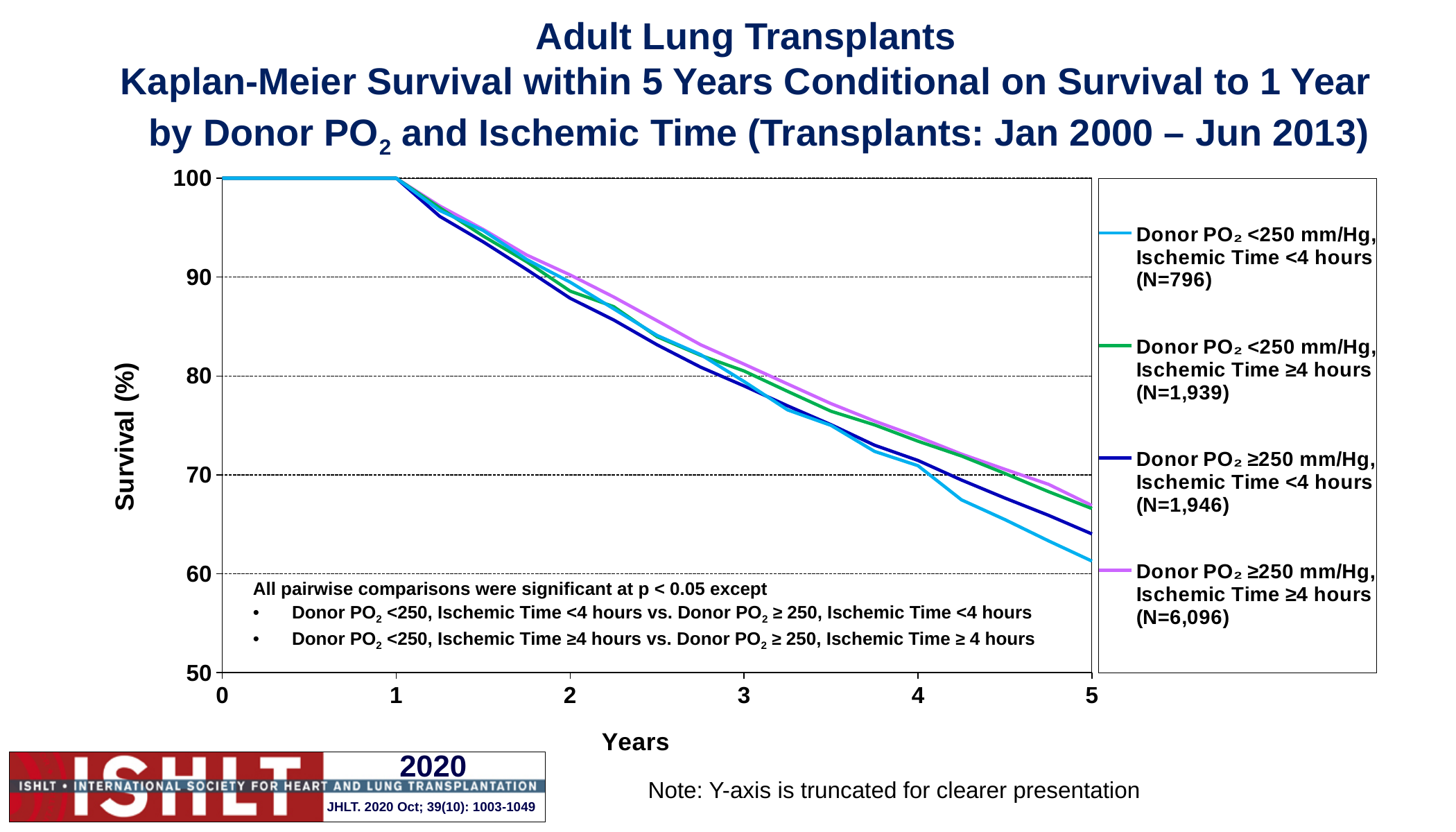
Is the survival value for the Donor PO₂ <250 mm/Hg, Ischemic Time <4 hours series at year 5 greater or less than 70? less At year 5, which series has the larger survival value: Donor PO₂ <250 mm/Hg, Ischemic Time <4 hours or Donor PO₂ ≥250 mm/Hg, Ischemic Time ≥4 hours? Donor PO₂ ≥250 mm/Hg, Ischemic Time ≥4 hours What is the label of the y axis? Survival (%) Is the survival value for the Donor PO₂ ≥250 mm/Hg, Ischemic Time ≥4 hours series at year 4 greater or less than 70? greater What kind of chart is shown on the slide? line chart How many series does the legend list? 4 What is the survival value for the Donor PO₂ ≥250 mm/Hg, Ischemic Time ≥4 hours series at year 1? 100 Is the survival value for the Donor PO₂ ≥250 mm/Hg, Ischemic Time <4 hours series at year 2 greater or less than 90? less Which series has the lowest survival at year 5? Donor PO₂ <250 mm/Hg, Ischemic Time <4 hours (N=796) What is the N for the Donor PO₂ ≥250 mm/Hg, Ischemic Time ≥4 hours series in the legend? N=6,096 Do the survival curves rise or fall along the x axis after year 1? fall How many tick marks are labelled on the Years axis? 6